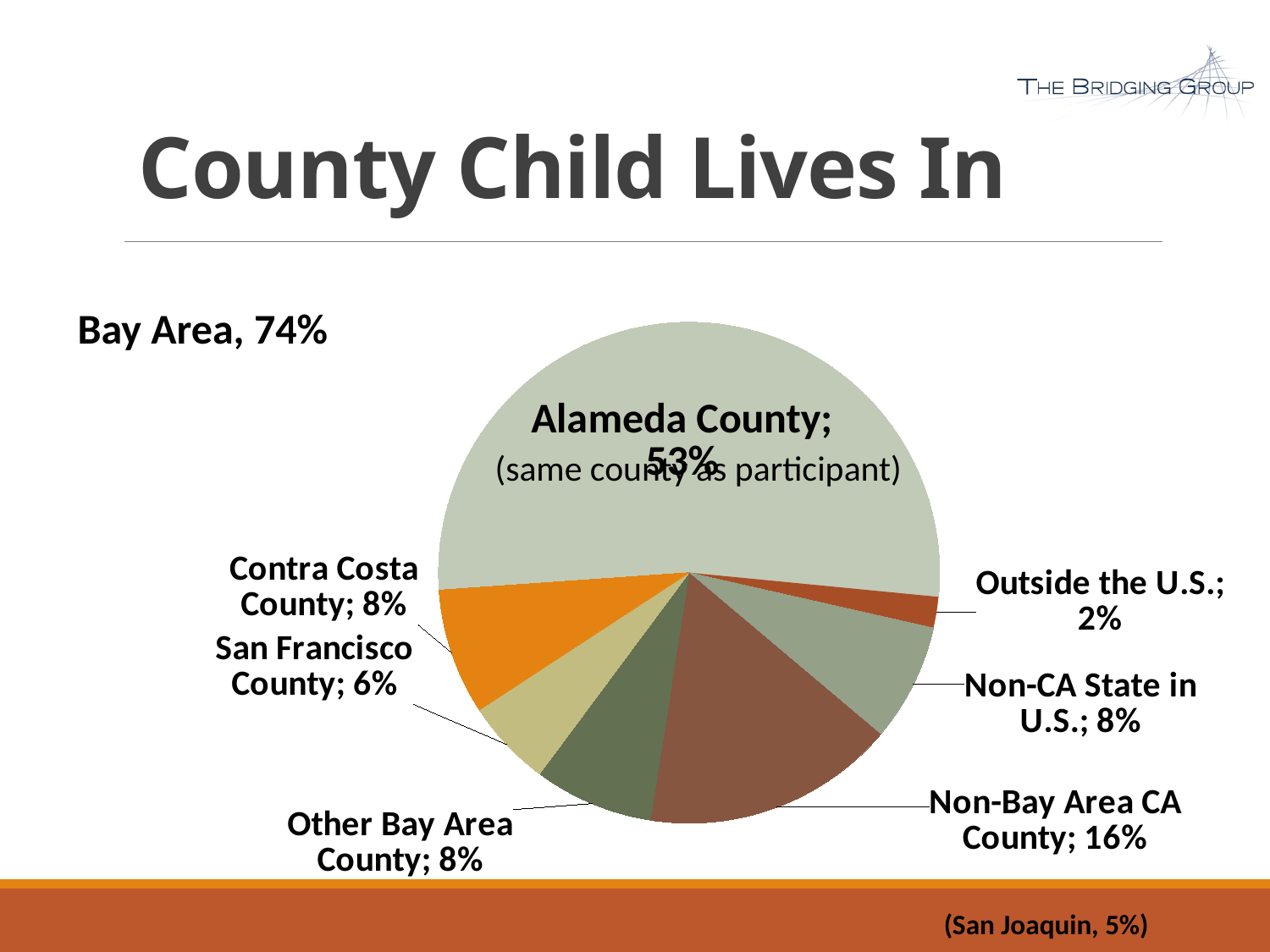
What percentage of children live in Alameda County? 53% Which slice of the pie chart is the smallest? Outside the U.S. What is the combined percentage of Contra Costa County and San Francisco County? 14% How many slices does the pie chart have? 7 What is the difference in percentage points between Alameda County and Non-Bay Area CA County? 37 What percentage of children live in a Non-Bay Area CA County? 16% What percentage of children live outside the U.S.? 2% Which is larger, the share for Contra Costa County or the share for San Francisco County? Contra Costa County What kind of chart is shown on the slide? pie chart What percentage of children live in San Francisco County? 6% Which slice of the pie chart is the largest? Alameda County What is the title of the slide containing the pie chart? County Child Lives In